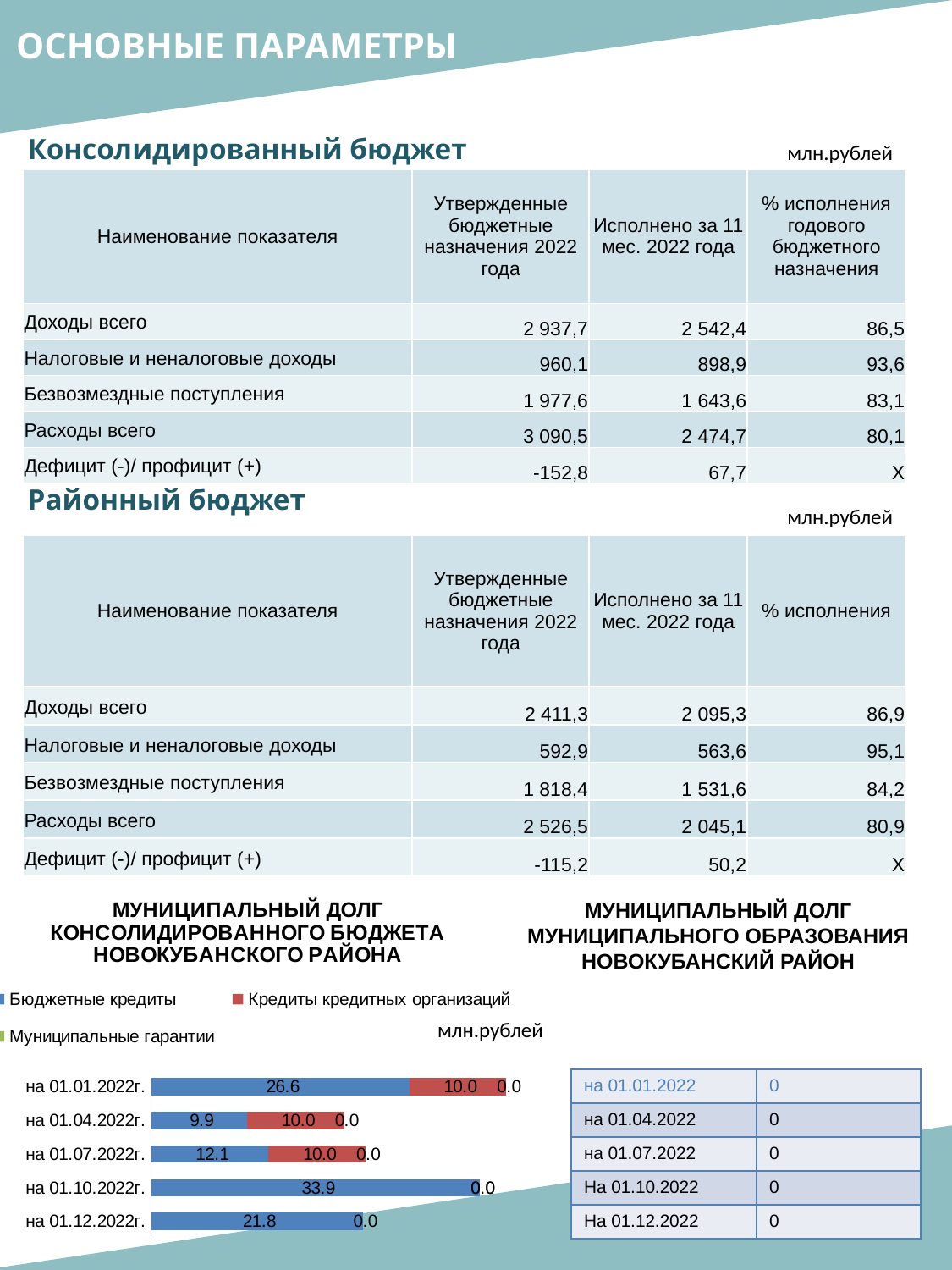
How many dates (categories) are plotted in the municipal debt chart? 5 In the municipal debt chart, on which date is Бюджетные кредиты the lowest? на 01.04.2022г. In the municipal debt chart, what is the value of Бюджетные кредиты on 01.01.2022? 26.6 In the municipal debt chart, what is the total of the stacked bar for 01.01.2022? 36.6 What kind of chart is shown at the bottom left of the slide? bar chart In the municipal debt chart, what is the value of Кредиты кредитных организаций on 01.07.2022? 10.0 In the municipal debt chart, on which date is Бюджетные кредиты the highest? на 01.10.2022г. In the municipal debt chart, what is the difference between Бюджетные кредиты on 01.10.2022 and on 01.12.2022? 12.1 In the municipal debt chart, what is the value of Бюджетные кредиты on 01.12.2022? 21.8 What unit is stated for the values in the municipal debt chart? млн.рублей In the municipal debt chart, which is larger: Бюджетные кредиты on 01.04.2022 or on 01.07.2022? на 01.07.2022г. How many series does the legend of the municipal debt chart list? 3